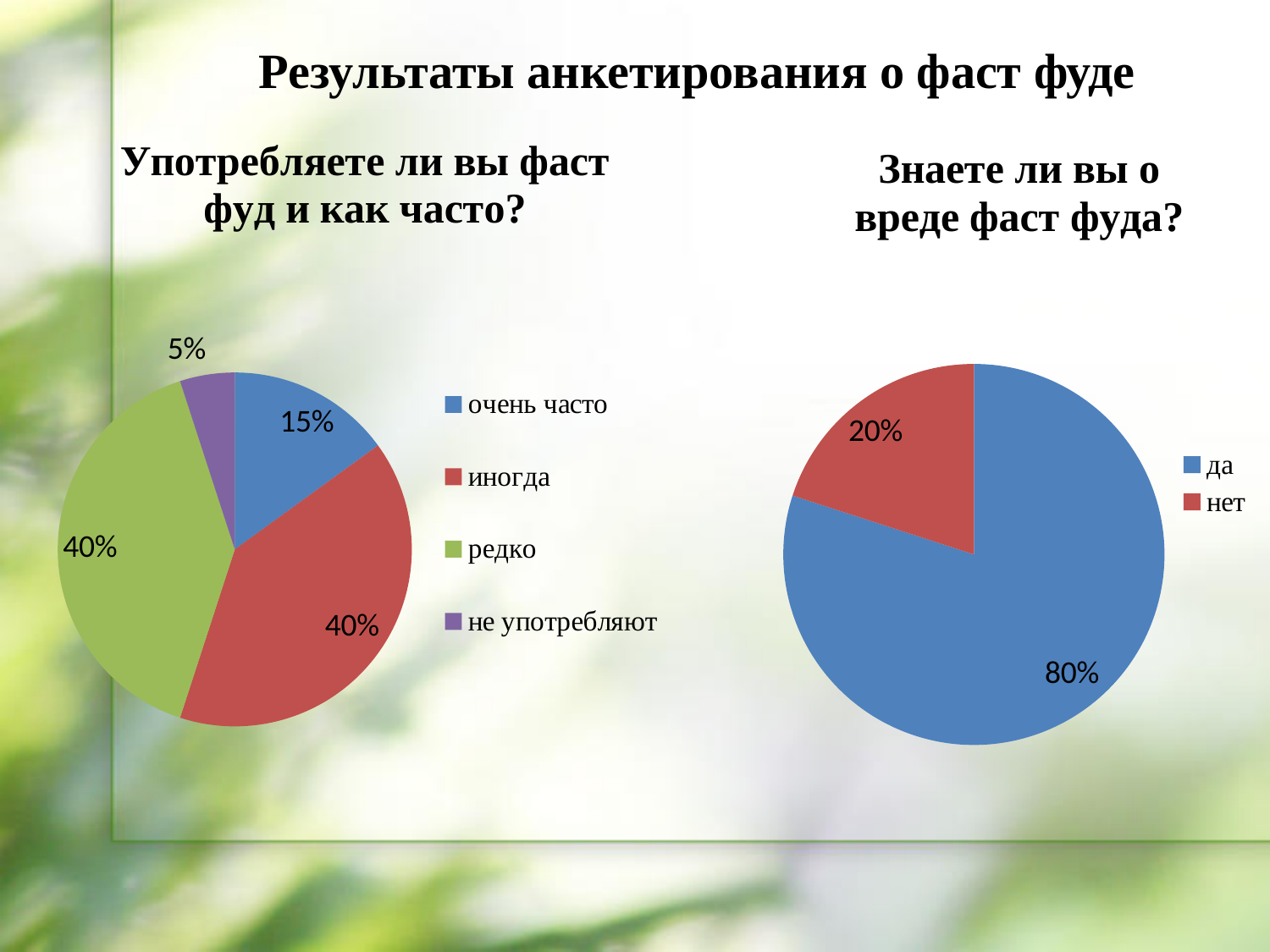
In the left chart "Употребляете ли вы фаст фуд и как часто?", what share is labelled for "не употребляют"? 5% In the right chart "Знаете ли вы о вреде фаст фуда?", which category has the largest slice? да In the right chart "Знаете ли вы о вреде фаст фуда?", what share is labelled for "да"? 80% In the left chart "Употребляете ли вы фаст фуд и как часто?", which category has the smallest slice? не употребляют What kind of chart is the right chart "Знаете ли вы о вреде фаст фуда?"? pie chart In the left chart "Употребляете ли вы фаст фуд и как часто?", which is larger: "очень часто" or "редко"? редко In the right chart "Знаете ли вы о вреде фаст фуда?", what is the difference between the shares for "да" and "нет"? 60% In the left chart "Употребляете ли вы фаст фуд и как часто?", what share is labelled for "очень часто"? 15% How many categories does the legend of the left chart "Употребляете ли вы фаст фуд и как часто?" list? 4 In the right chart "Знаете ли вы о вреде фаст фуда?", what share is labelled for "нет"? 20% In the left chart "Употребляете ли вы фаст фуд и как часто?", what share is labelled for "иногда"? 40% In the left chart "Употребляете ли вы фаст фуд и как часто?", what is the difference between the shares for "редко" and "очень часто"? 25%